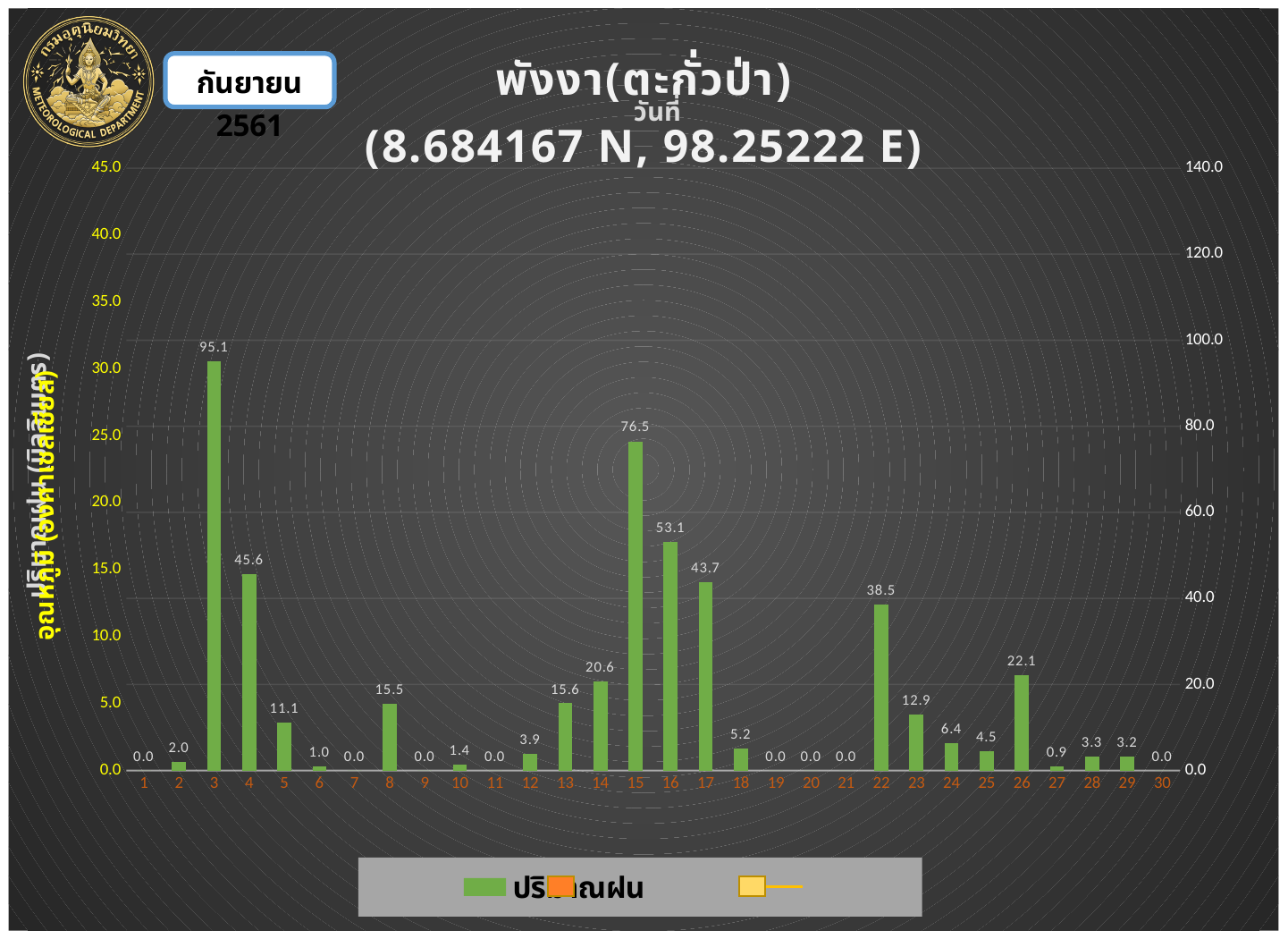
What is the rainfall value shown for day 3? 95.1 What is the difference between the rainfall values for day 16 and day 17? 9.4 Do the rainfall values rise or fall from day 15 to day 17? fall What is the difference between the rainfall values for day 3 and day 15? 18.6 Is the value for day 3 greater or less than 80.0 on the right axis? greater What is the rainfall value shown for day 22? 38.5 What is the rainfall value shown for day 15? 76.5 How many days are shown on the x axis? 30 Which is larger, the rainfall value for day 4 or for day 22? day 4 Which day has the highest rainfall value? 3 What kind of chart is shown on the slide? bar chart What is the rainfall value shown for day 26? 22.1